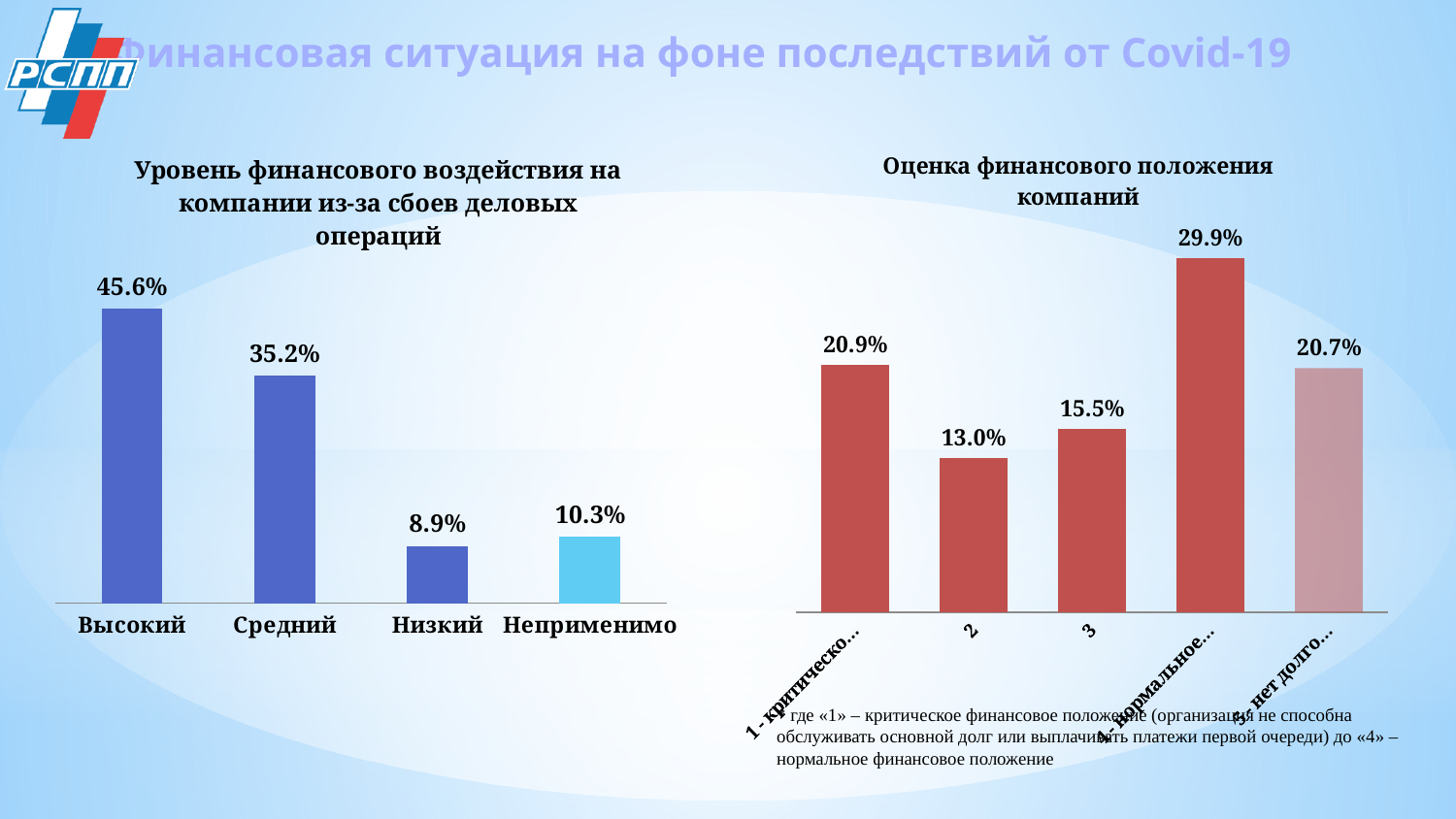
In the right chart 'Оценка финансового положения компаний', what is the value for category '3'? 15.5% In the right chart 'Оценка финансового положения компаний', which is larger: the value for category '1 - критическое' or category '3'? 1 - критическое What type of chart is the right chart 'Оценка финансового положения компаний'? Bar chart In the left chart 'Уровень финансового воздействия на компании из-за сбоев деловых операций', which bar is shown in a different (light blue) colour from the others? Неприменимо In the left chart 'Уровень финансового воздействия на компании из-за сбоев деловых операций', how many categories are shown? 4 In the left chart 'Уровень финансового воздействия на компании из-за сбоев деловых операций', what is the value for 'Неприменимо'? 10.3% In the right chart 'Оценка финансового положения компаний', which category has the highest value? 4 - нормальное In the right chart 'Оценка финансового положения компаний', how many categories are shown? 5 In the right chart 'Оценка финансового положения компаний', what is the value for category '2'? 13.0% In the left chart 'Уровень финансового воздействия на компании из-за сбоев деловых операций', which category has the lowest value? Низкий In the left chart 'Уровень финансового воздействия на компании из-за сбоев деловых операций', what is the value for 'Высокий'? 45.6% In the left chart 'Уровень финансового воздействия на компании из-за сбоев деловых операций', what is the difference between 'Высокий' and 'Средний'? 10.4%